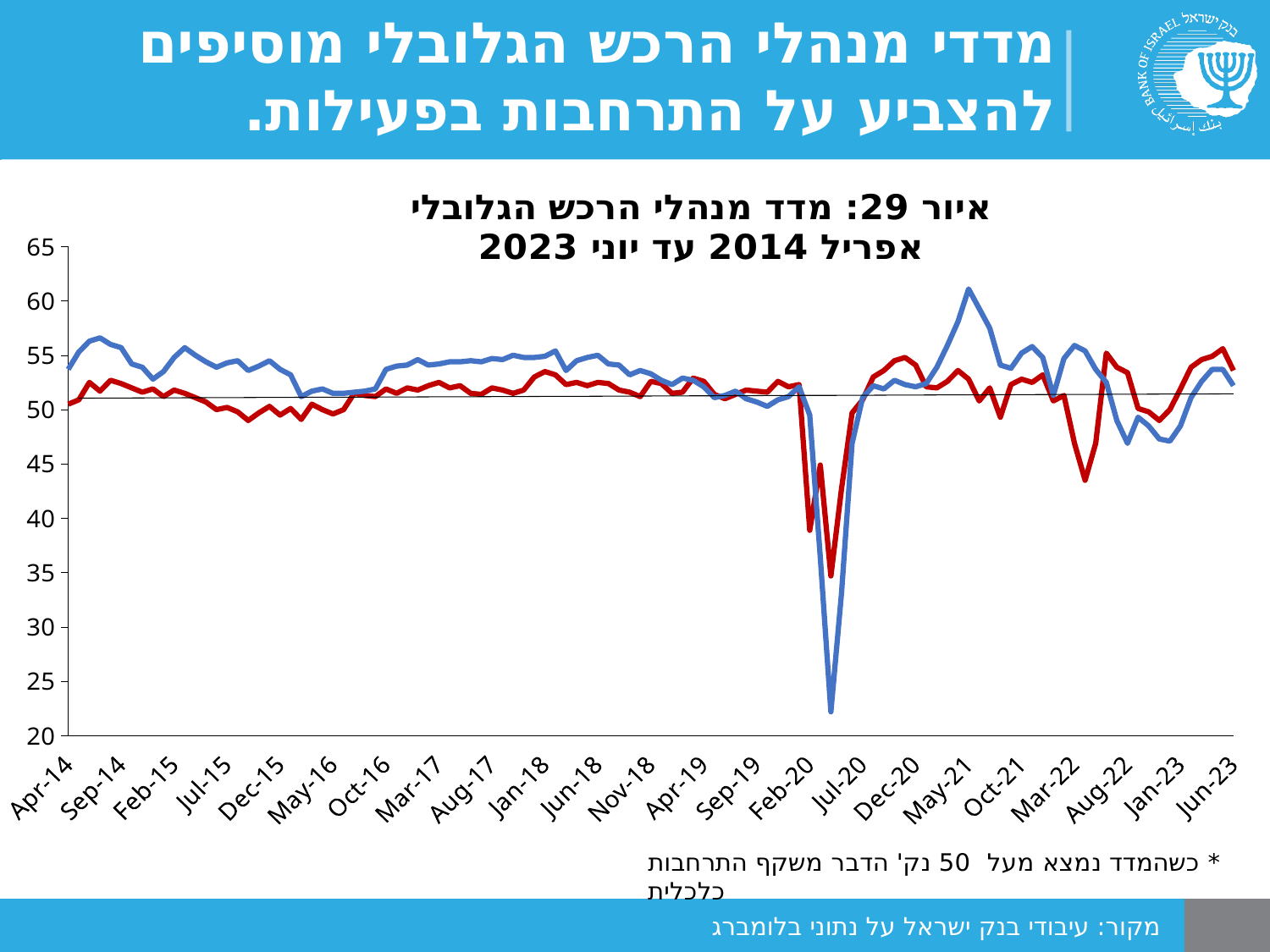
Is the lowest value of the blue line greater or less than 25? less Is the value of the red line near Mar-22 at its dip greater or less than 45? less How many lines are plotted on the chart? 2 Is the highest value of the blue line greater or less than 55? greater At the sharp dip near Jul-20, which line falls lower, the blue line or the red line? the blue line Near May-21, which line is higher, the blue line or the red line? the blue line How many month labels are shown on the x axis? 23 What is the title of the chart? איור 29: מדד מנהלי הרכש הגלובלי אפריל 2014 עד יוני 2023 Near which x-axis label does the blue line reach its lowest value? Feb-20 What kind of chart is shown on the slide? line chart